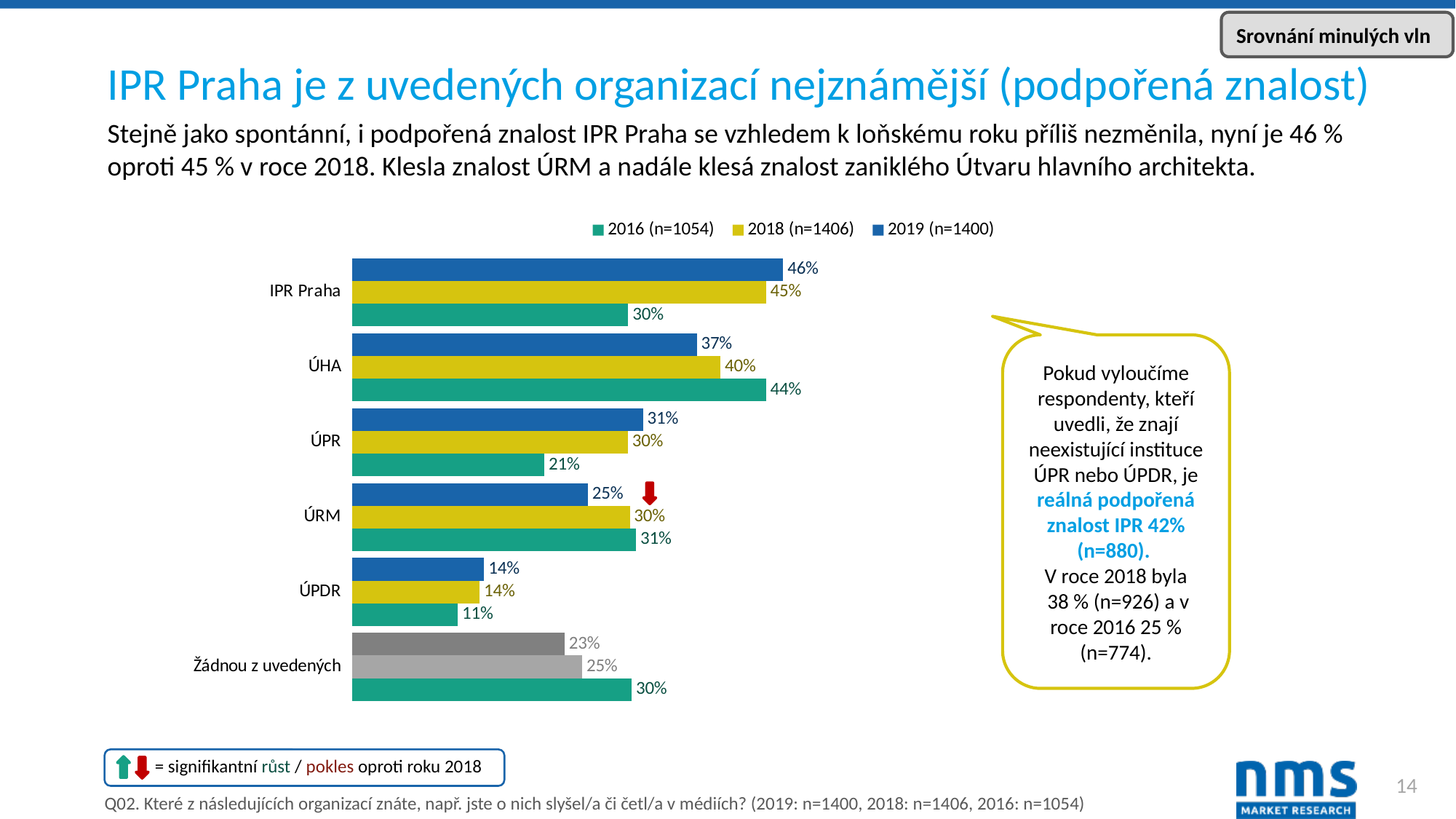
How many series does the legend list? 3 What kind of chart is shown on the slide? Bar chart What is the value for ÚRM in the 2018 (n=1406) series? 30% Which category has the lowest value in the 2016 (n=1054) series? ÚPDR What is the value for ÚHA in the 2016 (n=1054) series? 44% What is the value for IPR Praha in the 2019 (n=1400) series? 46% Which category is marked with a red arrow indicating a significant decrease compared to 2018? ÚRM Did the value for ÚRM rise or fall from 2016 to 2019? Fall How many categories are shown on the chart? 6 Which category has the highest value in the 2019 (n=1400) series? IPR Praha What is the difference between the 2019 and 2016 values for IPR Praha? 16% Which is larger for ÚHA: the 2018 value or the 2019 value? 2018